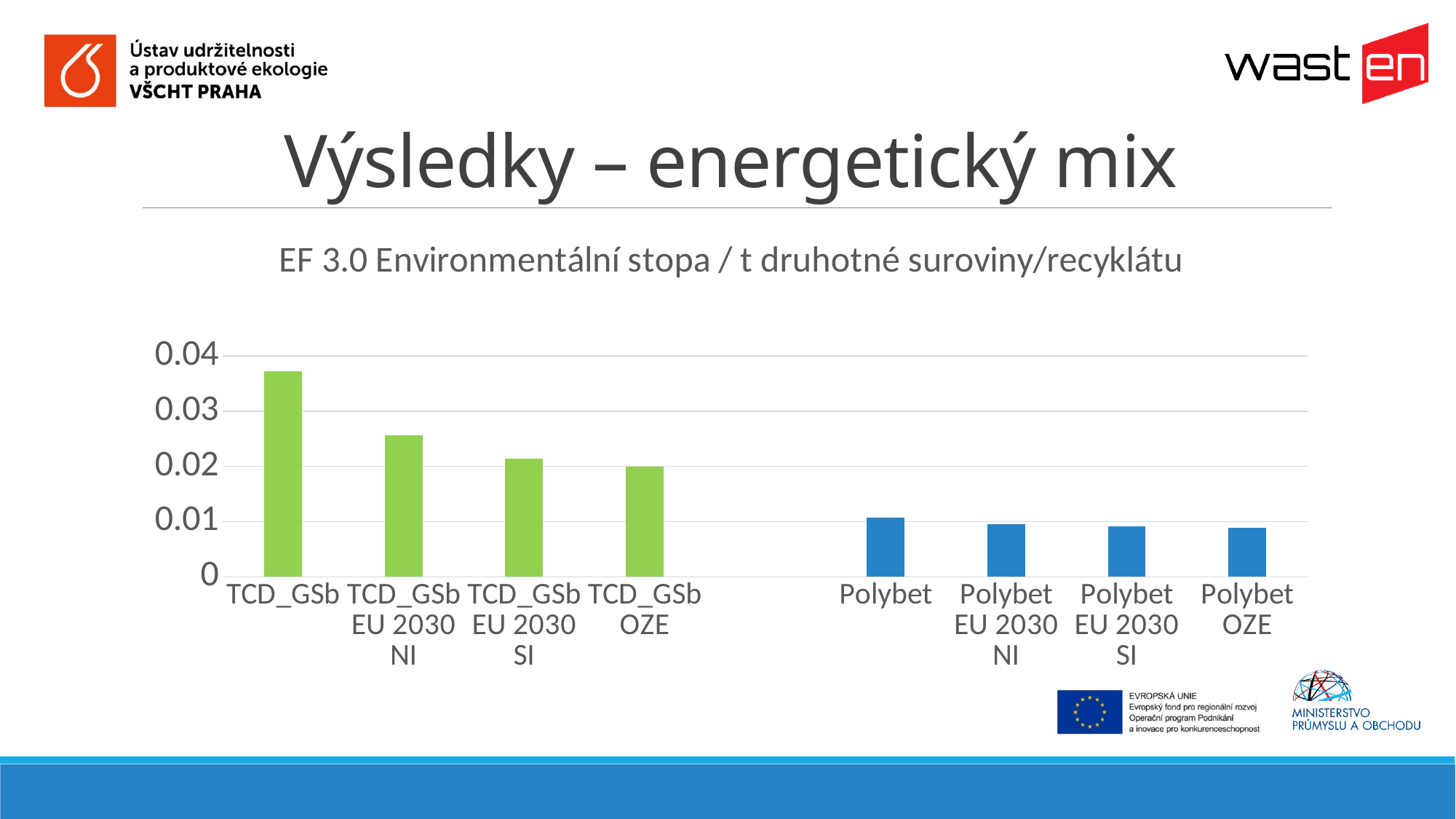
Which is larger, the value for TCD_GSb EU 2030 NI or the value for TCD_GSb OZE? TCD_GSb EU 2030 NI What kind of chart is shown on the slide? bar chart What is the title of the chart? EF 3.0 Environmentální stopa / t druhotné suroviny/recyklátu Which category has the highest value in the chart? TCD_GSb Is the value for TCD_GSb EU 2030 NI greater or less than 0.03? less Is the value for TCD_GSb greater or less than 0.03? greater Is the value for Polybet OZE greater or less than 0.01? less How many bars (categories) are plotted in the chart? 8 Which is larger, the value for TCD_GSb or the value for Polybet? TCD_GSb What colour are the bars for the Polybet categories? blue